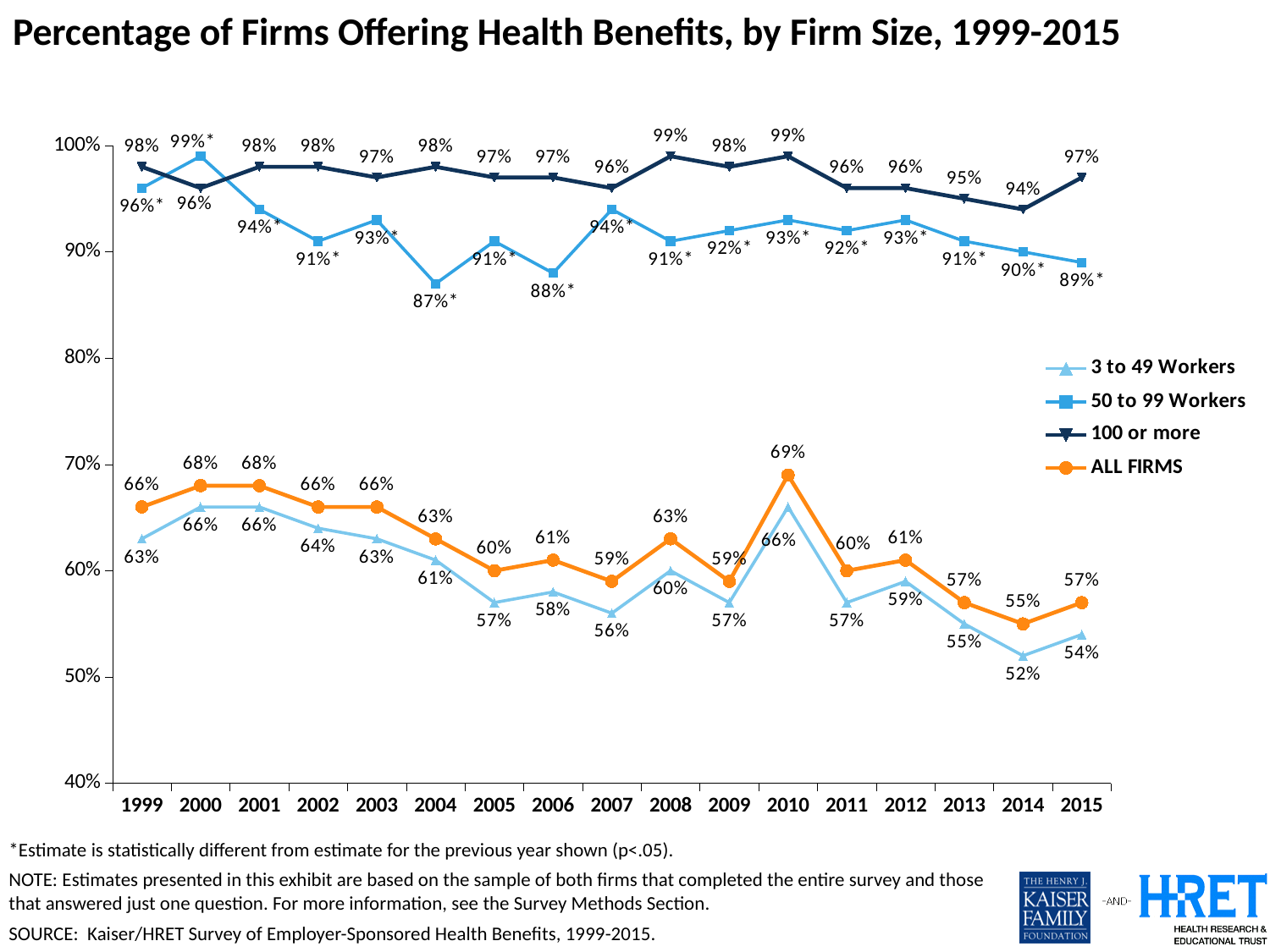
What is the difference between the ALL FIRMS value in 2000 and in 2015? 11% How many series does the legend list? 4 What kind of chart is this? Line chart In which year is the value for ALL FIRMS highest? 2010 Which is larger in 2007: the value for 100 or more or the value for 50 to 99 Workers? 100 or more In which year is the value for 3 to 49 Workers lowest? 2014 What is the value for 3 to 49 Workers in 2014? 52% What is the value for 100 or more in 2015? 97% How many years are shown on the x axis? 17 What is the value for 50 to 99 Workers in 2004? 87%* Does the value for 3 to 49 Workers rise or fall from 2010 to 2014? Fall What is the value for ALL FIRMS in 2010? 69%